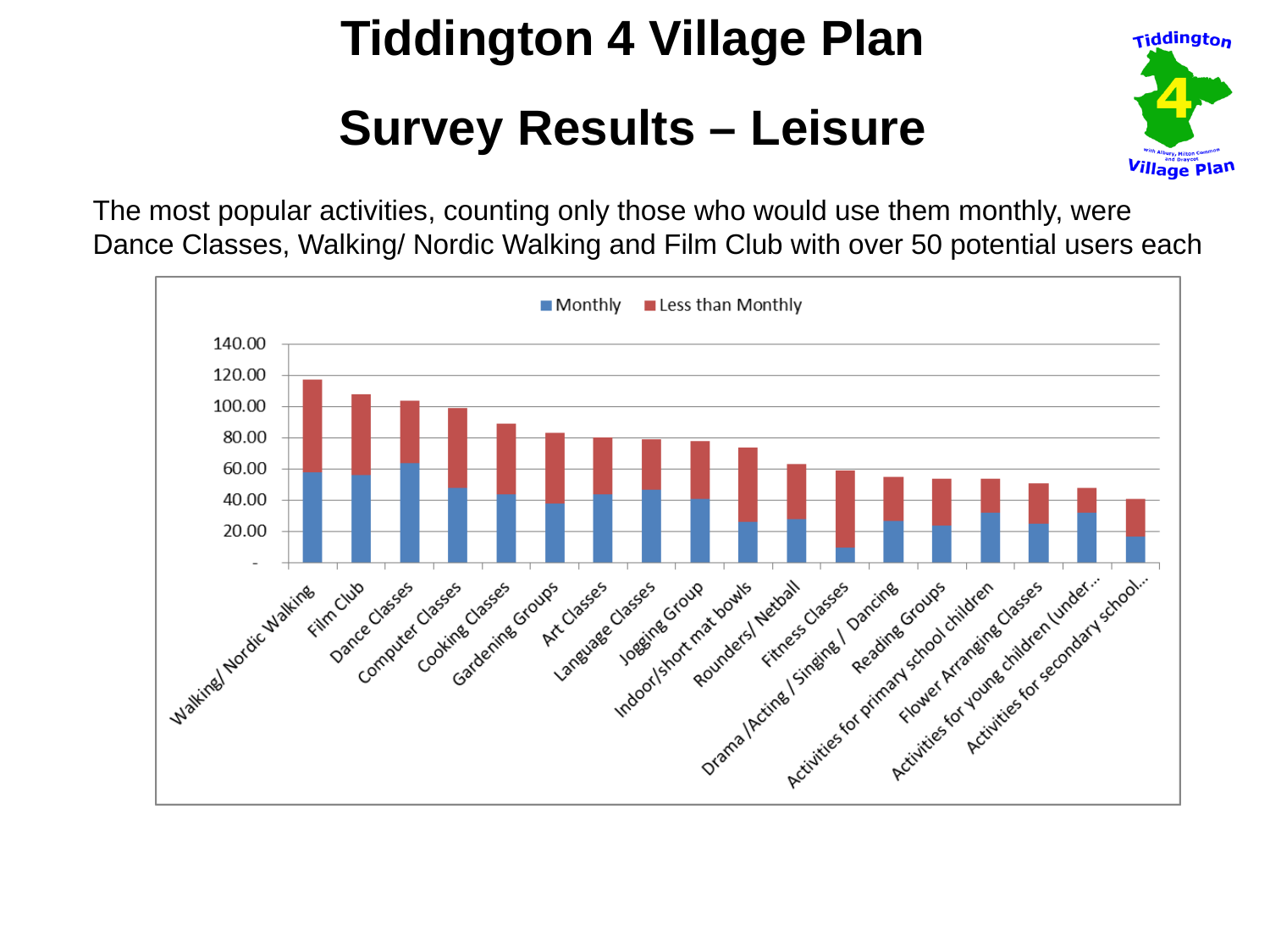
Which activity has the lowest total bar? Activities for secondary school... Is the total bar for Walking/ Nordic Walking greater or less than 100.00? greater Is the total bar for Activities for secondary school... greater or less than 60.00? less What kind of chart is shown on the slide? Stacked bar chart Which activity has the highest total (Monthly plus Less than Monthly) bar? Walking/ Nordic Walking Is the Monthly value for Fitness Classes greater or less than 20.00? less How many series does the legend list? 2 Which has the larger total bar, Walking/ Nordic Walking or Film Club? Walking/ Nordic Walking Which colour represents the Monthly series in the legend? Blue Do the total bar heights rise or fall moving from left to right along the x axis? fall How many activity categories are plotted on the x axis? 18 Which activity has the smallest Monthly (blue) segment? Fitness Classes